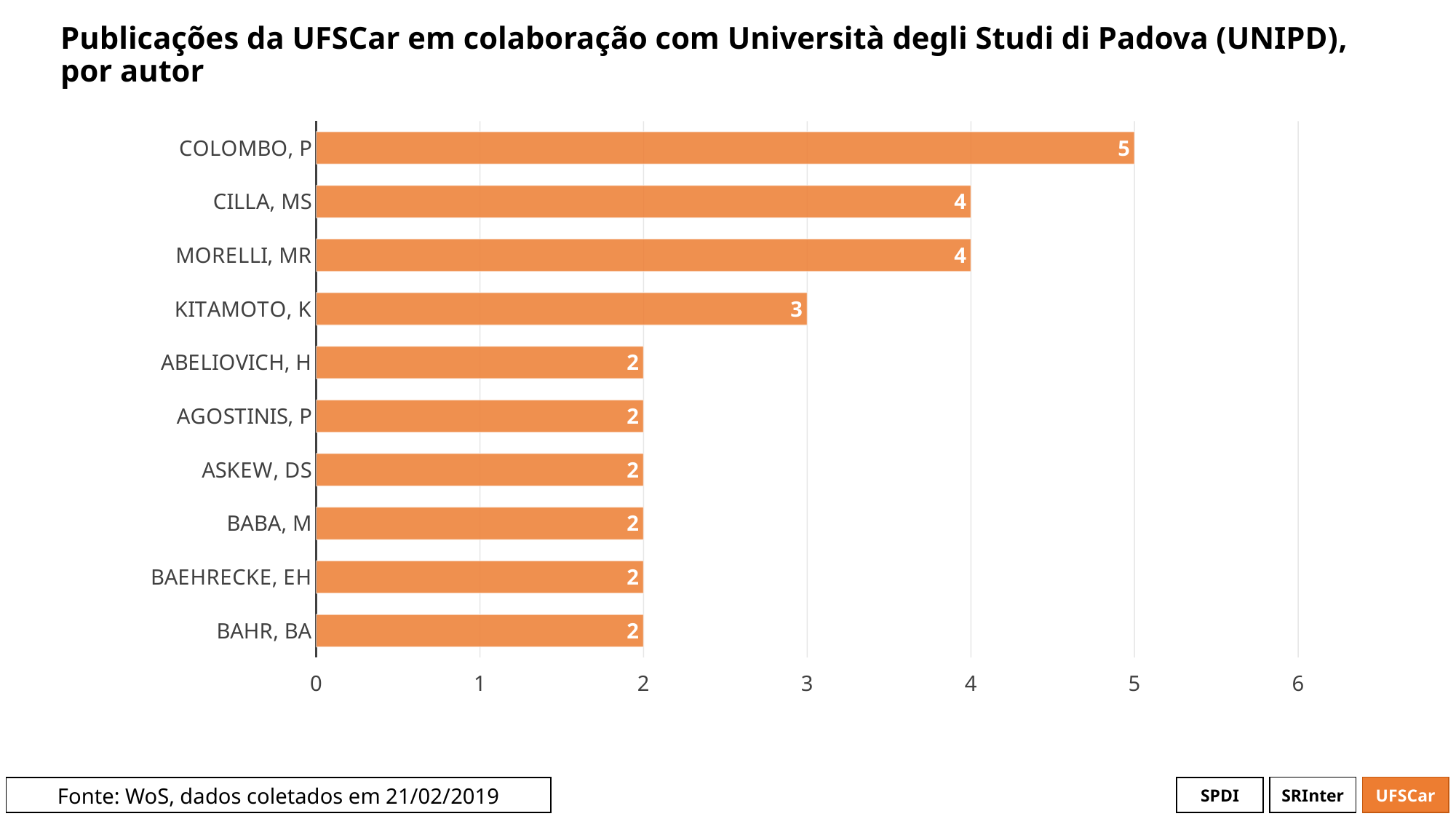
What is the difference between the values for CILLA, MS and BAHR, BA? 2 What is the value shown for KITAMOTO, K? 3 What is the difference between the values for COLOMBO, P and KITAMOTO, K? 2 How many authors are shown in the chart? 10 Which is larger, the value for CILLA, MS or the value for ASKEW, DS? CILLA, MS How many publications does COLOMBO, P have? 5 How many authors have a value of 2? 6 What is the value shown for MORELLI, MR? 4 Is the value for COLOMBO, P greater or less than 4? greater Which author has the highest number of publications? COLOMBO, P What is the data source stated at the bottom of the slide? WoS, dados coletados em 21/02/2019 What kind of chart is shown on the slide? bar chart